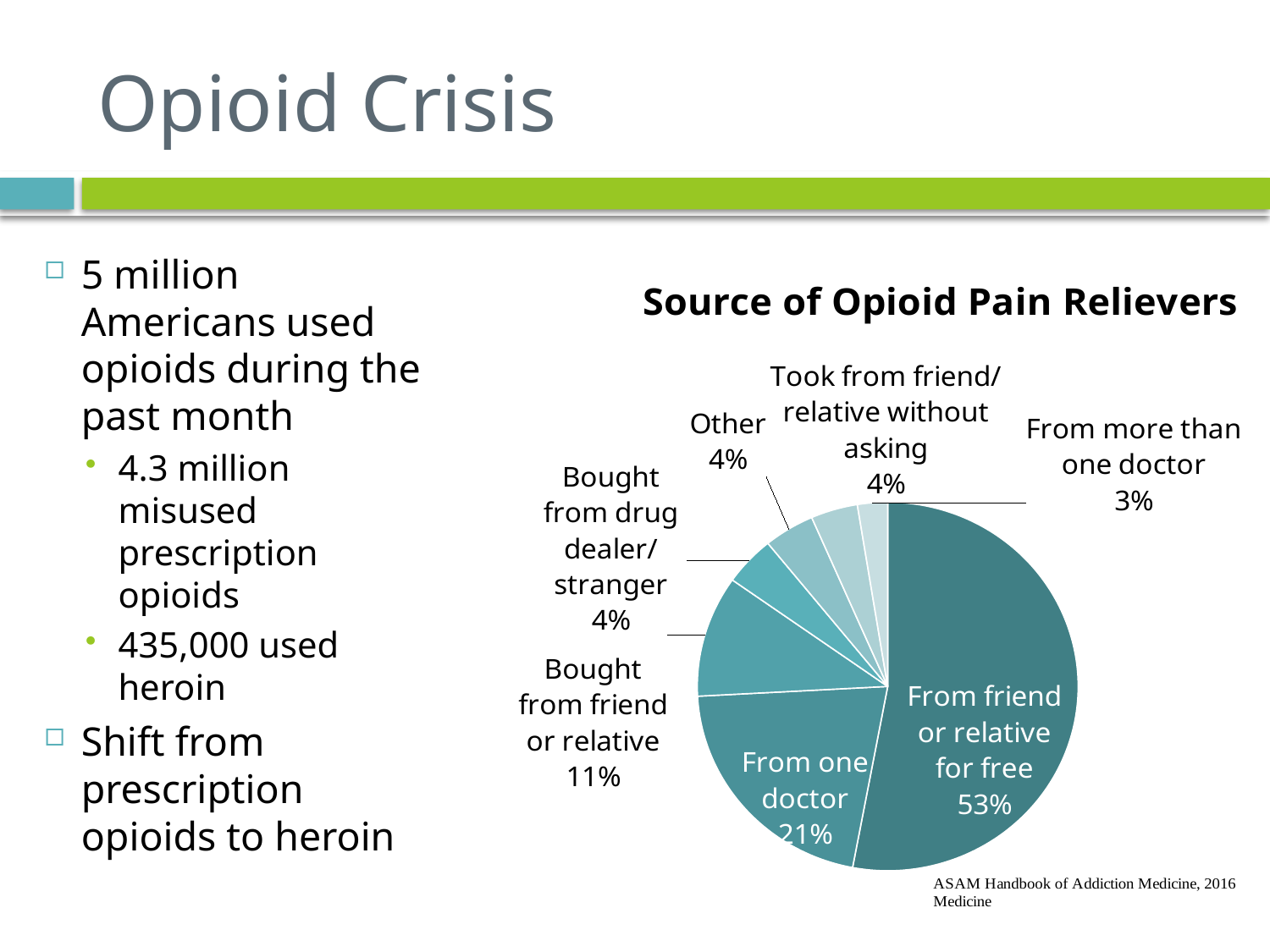
What share of the pie is 'Bought from drug dealer/stranger'? 4% What share of the pie is 'Bought from friend or relative'? 11% What share of the pie is 'From more than one doctor'? 3% How many slices does the pie chart have? 7 What is the title of the chart? Source of Opioid Pain Relievers What type of chart is shown on the slide? pie chart Which source has the smallest slice of the pie? From more than one doctor What is the difference in percentage points between 'From friend or relative for free' and 'From one doctor'? 32 Which is larger, 'From one doctor' or 'Bought from friend or relative'? From one doctor Which source has the largest slice of the pie? From friend or relative for free